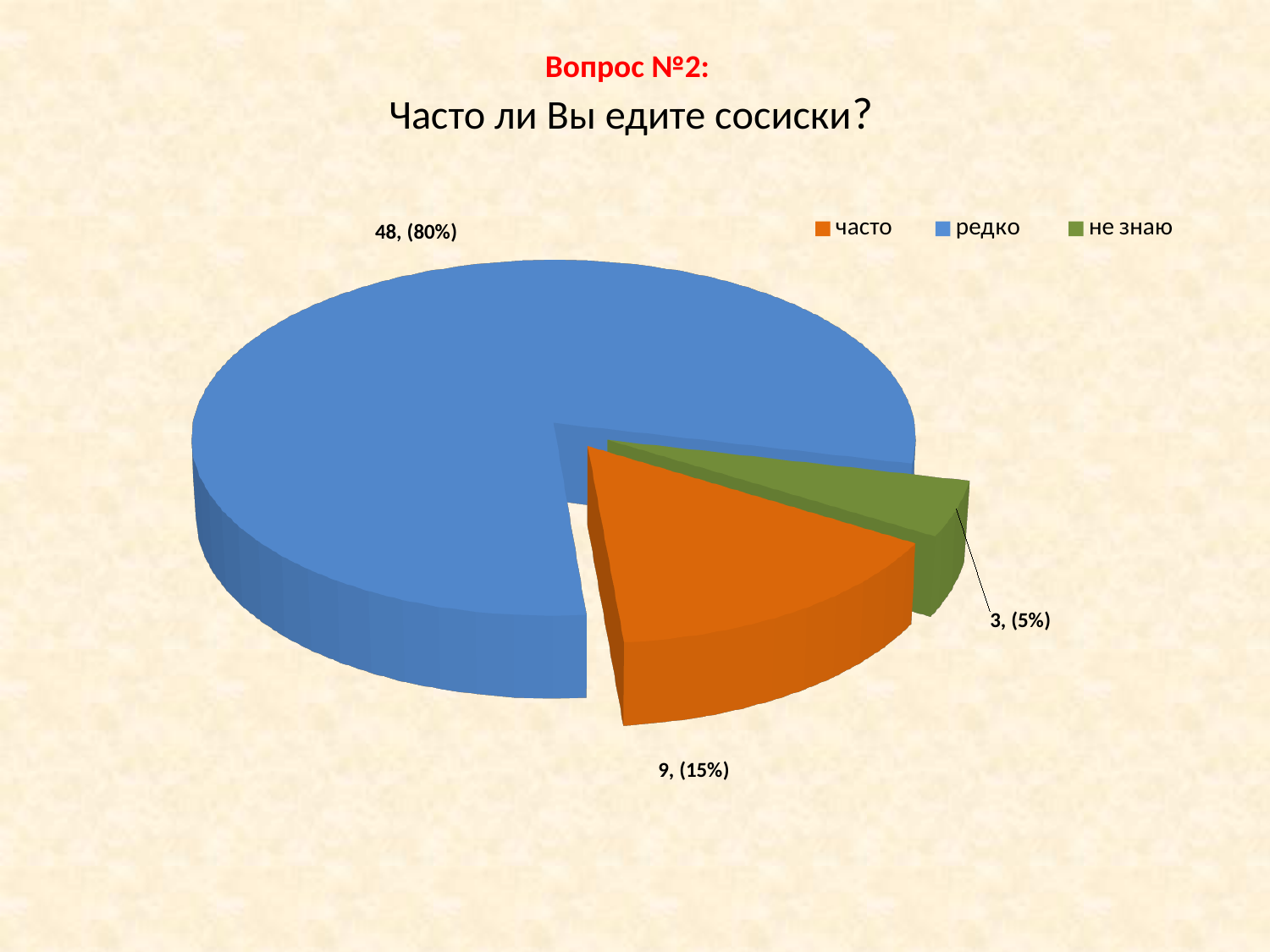
Which is larger, the value for "часто" or for "не знаю"? часто How many entries does the legend list? 3 What is the value for "редко"? 48, (80%) Which category has the largest slice? редко What share of the pie does "часто" represent? 15% How many slices does the pie chart have? 3 What colour is the slice for "редко"? blue What is the value for "не знаю"? 3, (5%) Which category has the smallest slice? не знаю What kind of chart is shown on the slide? pie chart What is the difference between the counts for "редко" and "часто"? 39 What is the value for "часто"? 9, (15%)